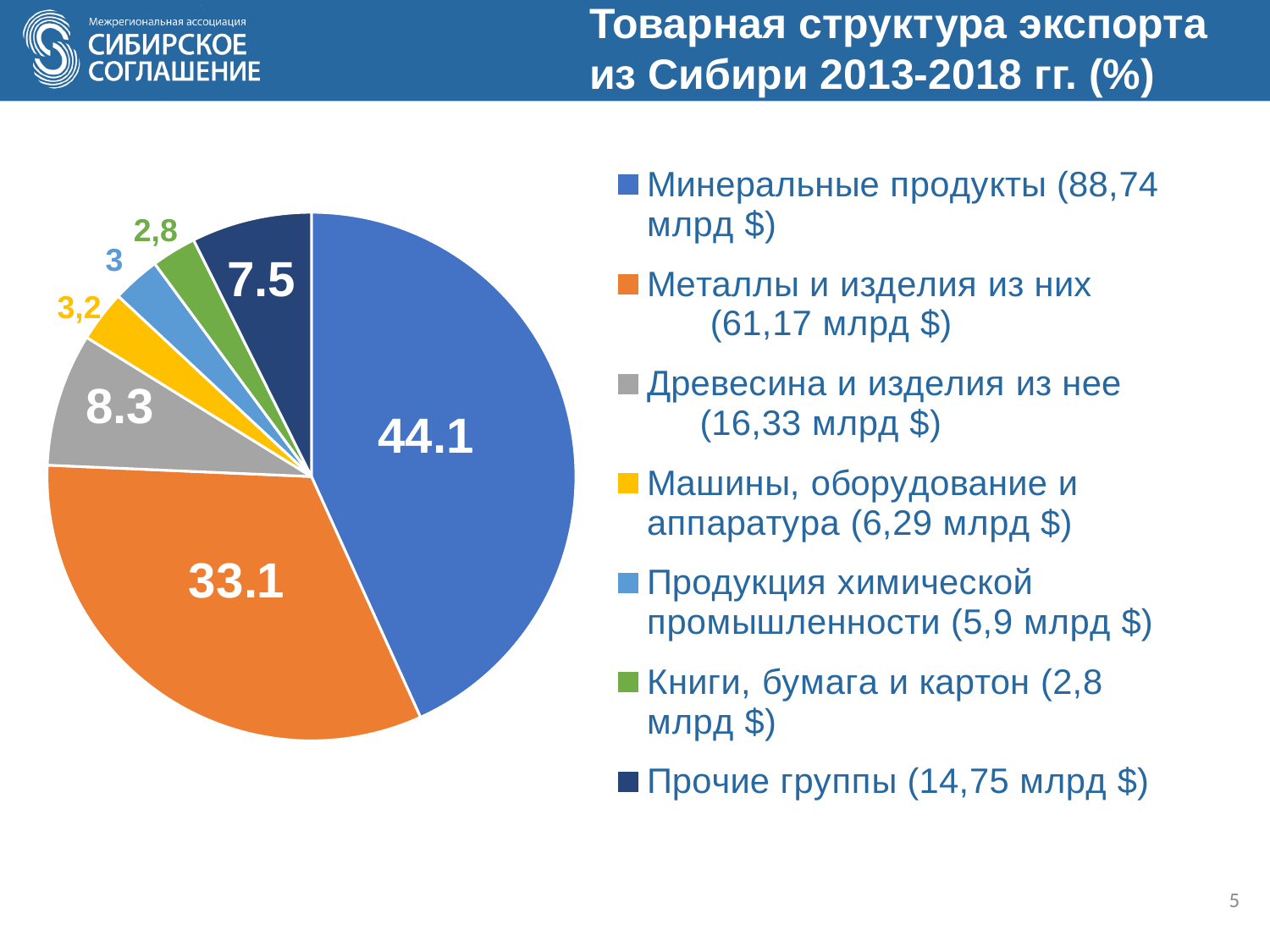
What type of chart is shown on the slide? pie chart Which category has the largest slice of the pie? Минеральные продукты What is the value shown for the Книги, бумага и картон slice? 2,8 What is the value shown for the Древесина и изделия из нее slice? 8.3 Which category has the smallest slice of the pie? Книги, бумага и картон What is the difference between the values for Минеральные продукты and Металлы и изделия из них? 11 What is the value shown for the Прочие группы slice? 7.5 What is the title of the chart on the slide? Товарная структура экспорта из Сибири 2013-2018 гг. (%) Which is larger: the slice for Древесина и изделия из нее or the slice for Прочие группы? Древесина и изделия из нее What is the value shown for the Металлы и изделия из них slice? 33.1 What is the value shown for the Минеральные продукты slice? 44.1 How many slices does the pie chart have? 7